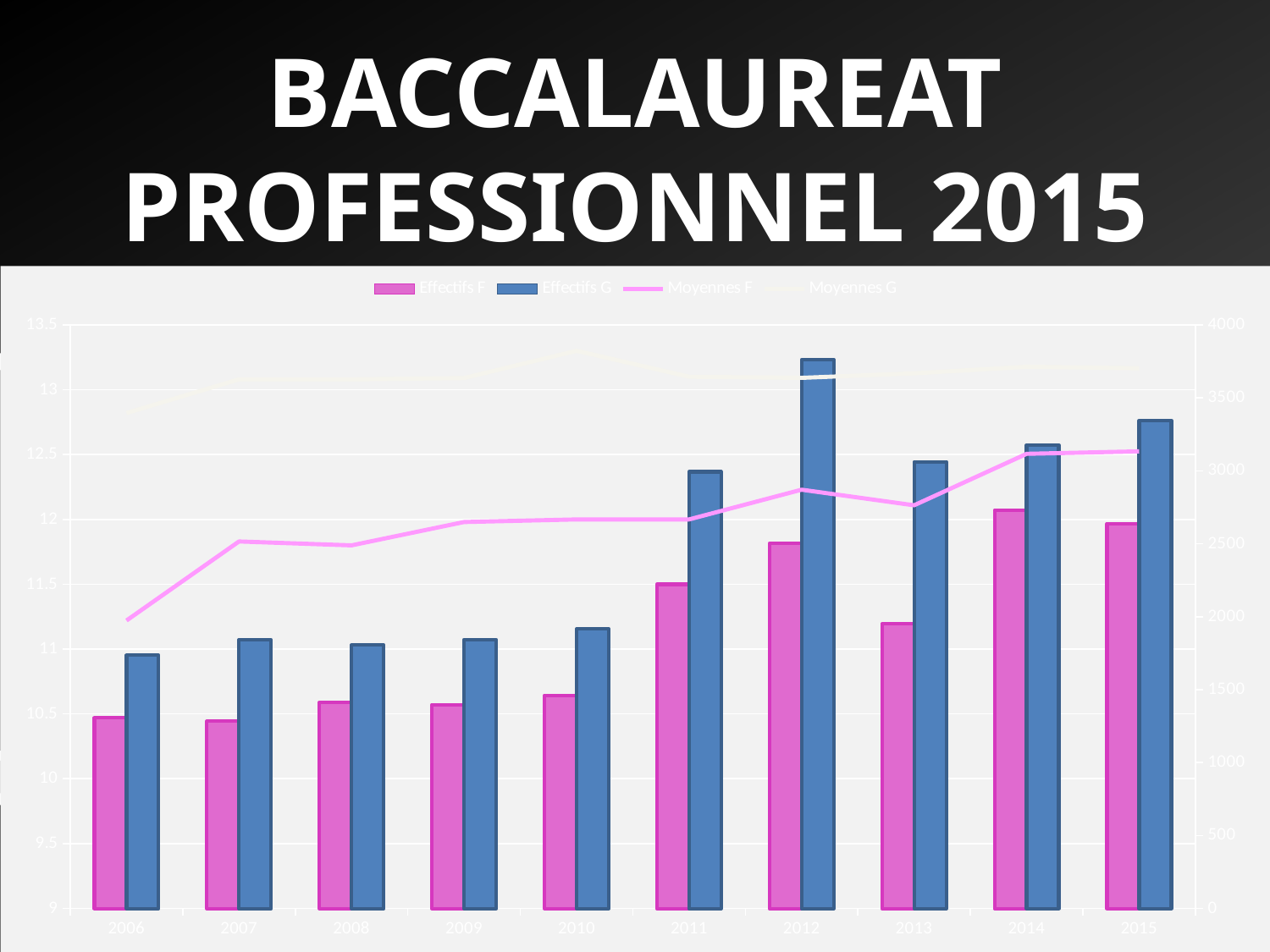
Which series is drawn with pink/magenta bars? Effectifs F How many series does the chart legend list? 4 Which is larger, the Effectifs F bar for 2014 or the Effectifs F bar for 2008? 2014 Which is larger, the Effectifs F bar for 2011 or the Effectifs F bar for 2013? 2011 In 2006, which line is higher, Moyennes F or Moyennes G? Moyennes G How many years are shown on the x axis of the chart? 10 Does the Moyennes F line generally rise or fall from 2006 to 2015? Rise What is the first year shown on the x axis? 2006 In which year is the Effectifs G bar the tallest? 2012 What kind of chart is shown on the slide? A combined bar and line chart